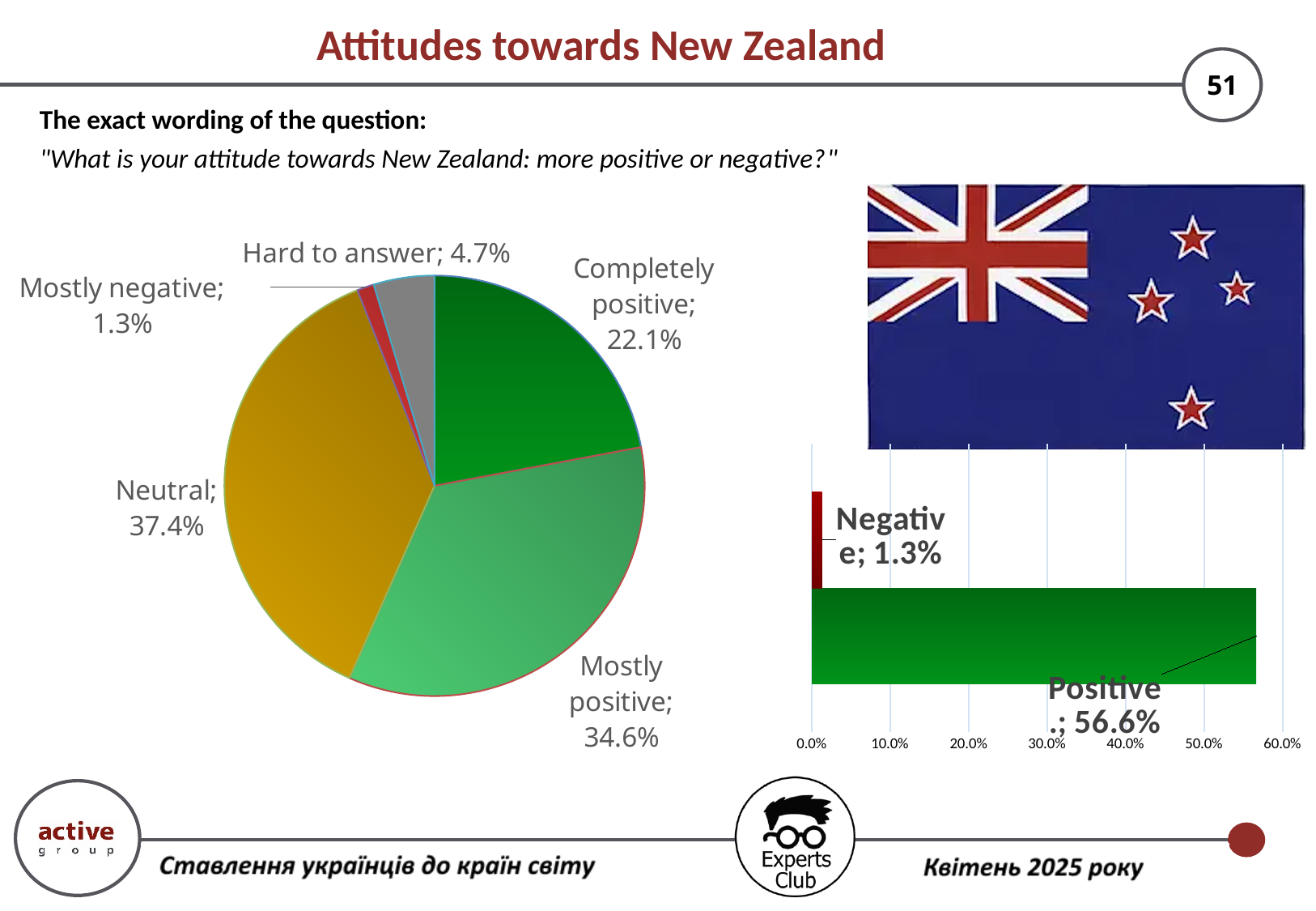
In the pie chart on the left, what share of respondents answered 'Hard to answer'? 4.7% In the bar chart on the right, what is the value for 'Negative'? 1.3% In the pie chart on the left, which category has the smallest share? Mostly negative In the bar chart on the right, what is the value for 'Positive'? 56.6% In the pie chart on the left, what share of respondents answered 'Neutral'? 37.4% In the pie chart on the left, which is larger: 'Completely positive' or 'Mostly positive'? Mostly positive In the pie chart on the left, which category has the largest share? Neutral In the bar chart on the right, what is the difference between the 'Positive' and 'Negative' values? 55.3 percentage points In the pie chart on the left, what share of respondents answered 'Completely positive'? 22.1% What type of chart is shown on the right side of the slide? Bar chart In the pie chart on the left, how many categories are shown? 5 In the pie chart on the left, what is the difference between the 'Neutral' and 'Mostly positive' shares? 2.8 percentage points